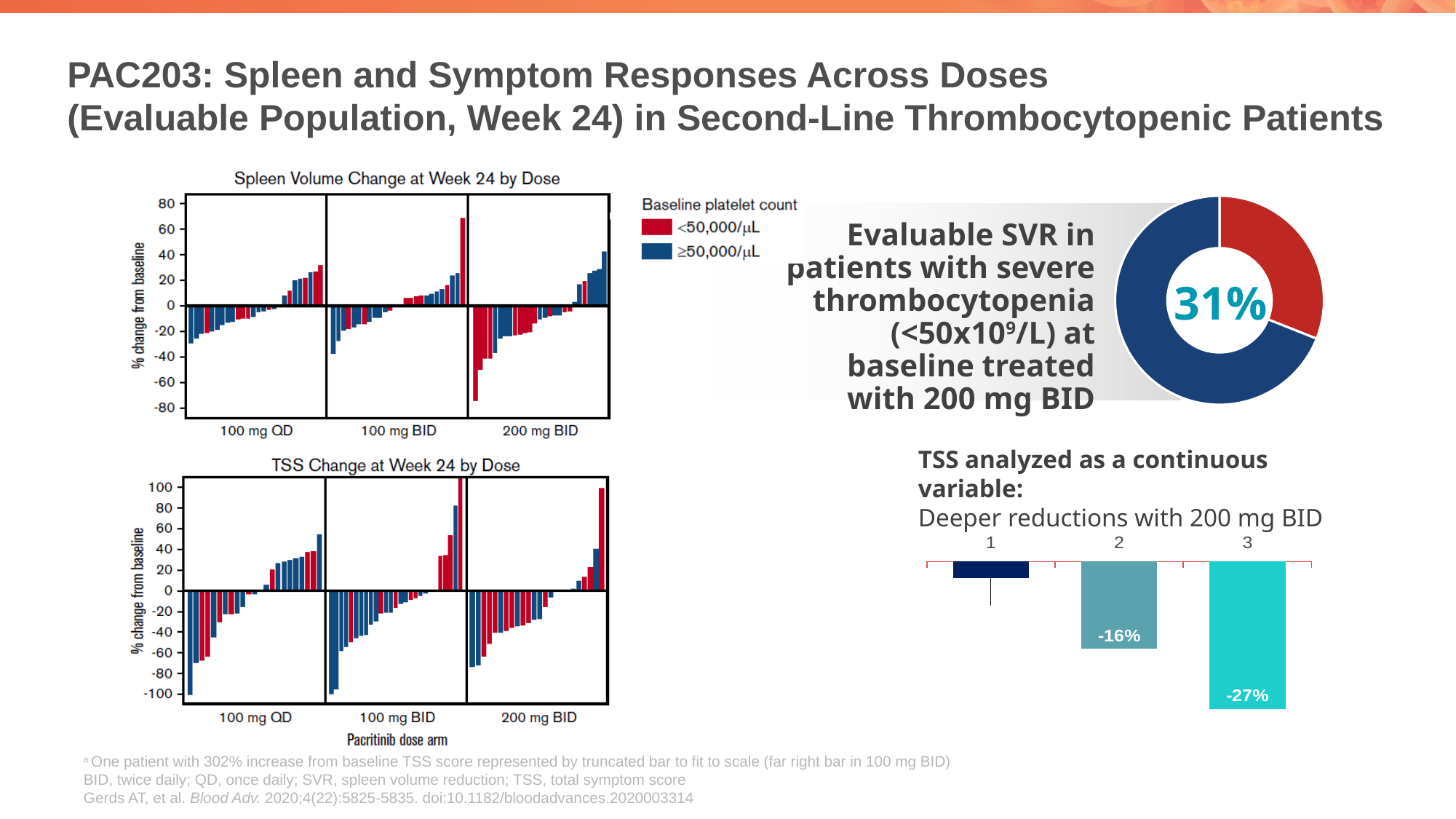
In the 'Spleen Volume Change at Week 24 by Dose' chart, how many series does the baseline platelet count legend list? 2 In the 'Spleen Volume Change at Week 24 by Dose' chart, is the tallest bar in the 100 mg BID panel greater or less than 60? greater In the donut chart on the right, what share is shown for evaluable SVR in patients with severe thrombocytopenia treated with 200 mg BID? 31% In the bar chart under 'TSS analyzed as a continuous variable', what is the difference between the values for category 2 and category 3? 11 percentage points What kind of chart is used to show the 31% evaluable SVR figure? donut (pie) chart In the bar chart under 'TSS analyzed as a continuous variable', what is the value shown for category 2? -16% In the 'TSS Change at Week 24 by Dose' chart, is the lowest bar in the 100 mg BID panel greater or less than -80? less In the bar chart under 'TSS analyzed as a continuous variable', which category has the lowest value? 3 In the 'Spleen Volume Change at Week 24 by Dose' chart, how many dose arms are shown along the x axis? 3 In the bar chart under 'TSS analyzed as a continuous variable', what is the value shown for category 3? -27% In the bar chart under 'TSS analyzed as a continuous variable', do the values rise or fall from category 1 to category 3? fall In the bar chart under 'TSS analyzed as a continuous variable', how many bars are plotted? 3